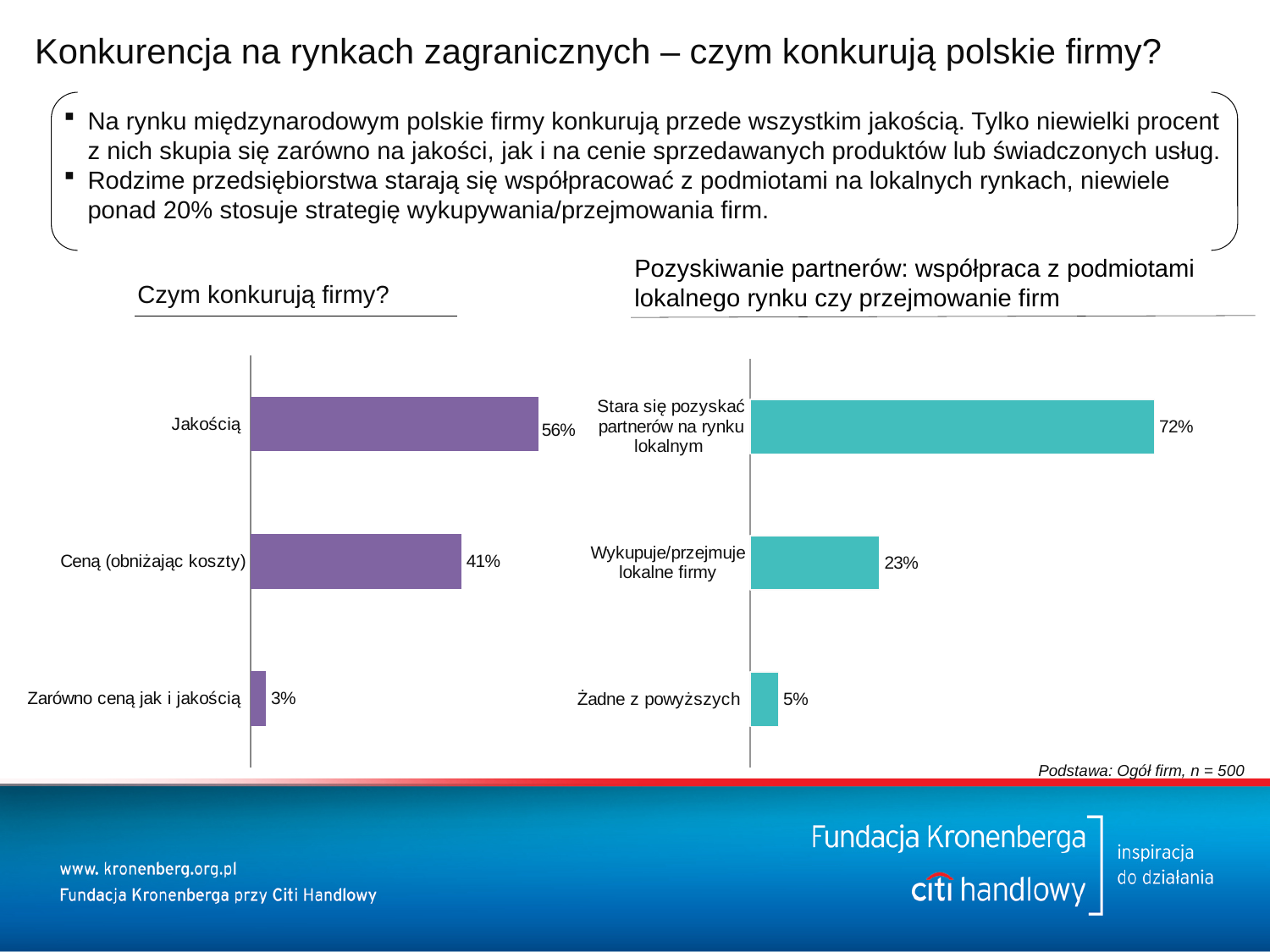
In the 'Pozyskiwanie partnerów' chart, which category has the highest value? Stara się pozyskać partnerów na rynku lokalnym In the 'Czym konkurują firmy?' chart, how many categories are shown? 3 In the 'Czym konkurują firmy?' chart, what is the value for 'Jakością'? 56% What is the sample size stated at the bottom of the charts? n = 500 What type of chart is the 'Czym konkurują firmy?' chart? Bar chart In the 'Czym konkurują firmy?' chart, what is the value for 'Ceną (obniżając koszty)'? 41% In the 'Pozyskiwanie partnerów' chart, what is the difference between 'Stara się pozyskać partnerów na rynku lokalnym' and 'Wykupuje/przejmuje lokalne firmy'? 49% In the 'Pozyskiwanie partnerów' chart, what is the value for 'Wykupuje/przejmuje lokalne firmy'? 23% In the 'Pozyskiwanie partnerów' chart, what is the value for 'Żadne z powyższych'? 5% In the 'Czym konkurują firmy?' chart, which category has the lowest value? Zarówno ceną jak i jakością Which is larger: 'Jakością' in the left chart or 'Stara się pozyskać partnerów na rynku lokalnym' in the right chart? Stara się pozyskać partnerów na rynku lokalnym In the 'Czym konkurują firmy?' chart, what is the difference between 'Jakością' and 'Ceną (obniżając koszty)'? 15%